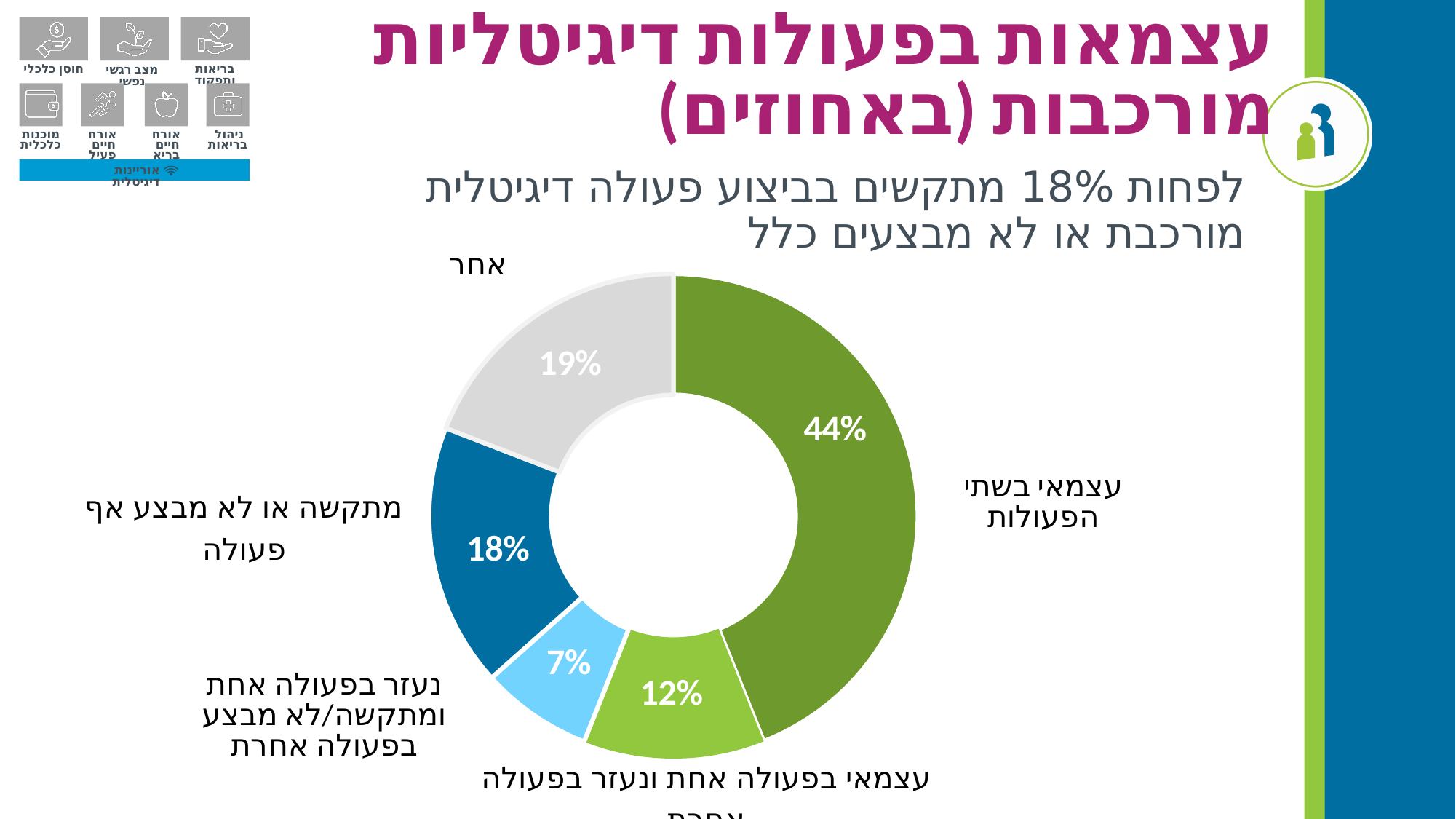
Which slice of the pie chart is the largest? עצמאי בשתי הפעולות What percentage is shown for the slice labelled "מתקשה או לא מבצע אף פעולה"? 18% Which slice of the pie chart is the smallest? נעזר בפעולה אחת ומתקשה/לא מבצע בפעולה אחרת What percentage is shown for the slice labelled "אחר"? 19% Which slice is larger: "אחר" or "מתקשה או לא מבצע אף פעולה"? אחר What percentage is shown for the slice labelled "עצמאי בשתי הפעולות"? 44% What is the difference in percentage points between the "עצמאי בשתי הפעולות" slice and the "מתקשה או לא מבצע אף פעולה" slice? 26 What kind of chart is shown on the slide? doughnut chart How many slices does the pie chart have? 5 What percentage is shown for the slice labelled "נעזר בפעולה אחת ומתקשה/לא מבצע בפעולה אחרת"? 7% What is the title of the chart on the slide? עצמאות בפעולות דיגיטליות מורכבות (באחוזים) What colour is the largest slice of the pie chart? green